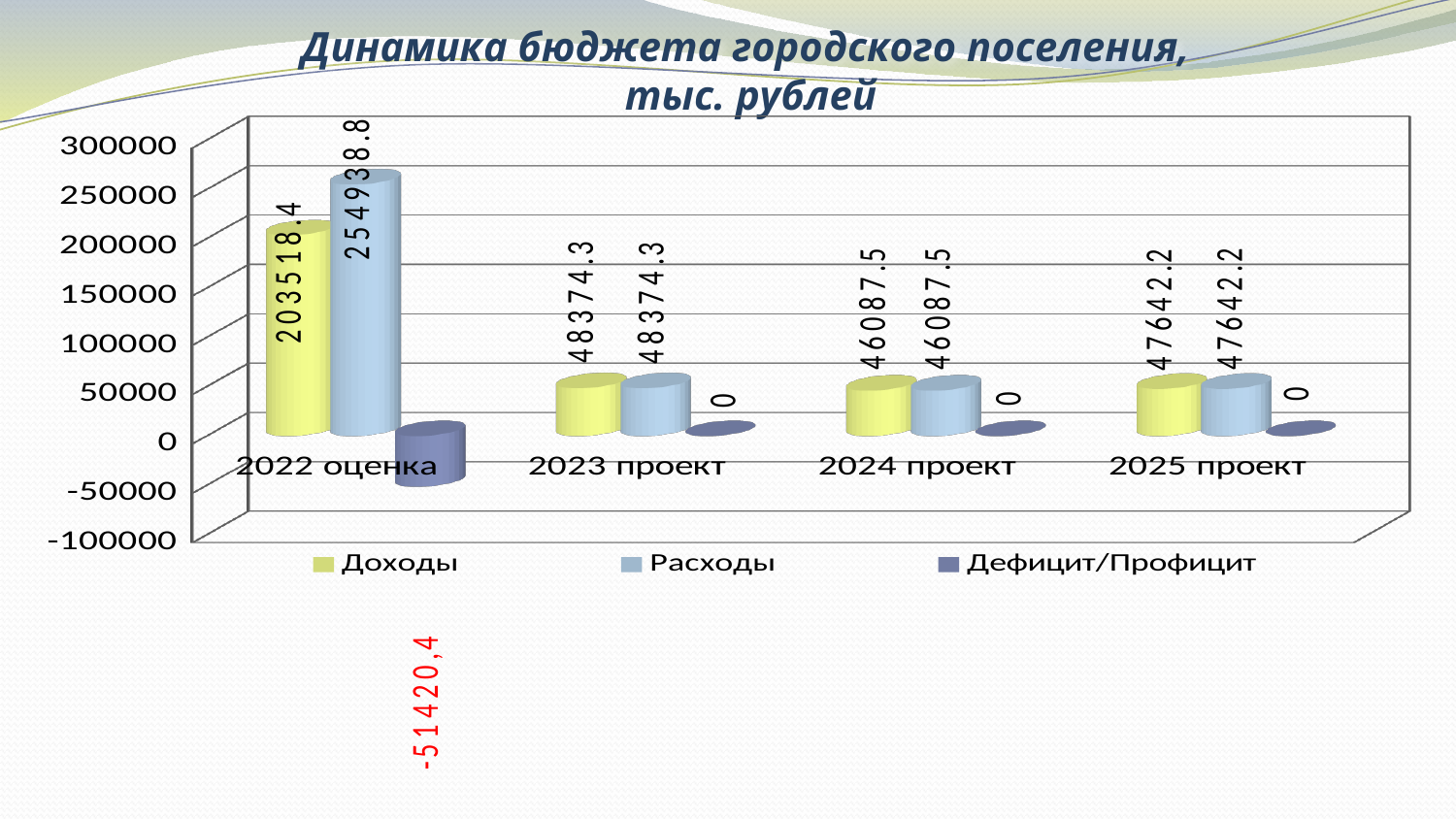
What is the value of Доходы for 2024 проект? 46087.5 What is the value of Расходы for 2022 оценка? 254938.8 How many categories are shown on the x axis? 4 How many series does the legend list? 3 What kind of chart is shown on the slide? bar chart What is the value of Расходы for 2025 проект? 47642.2 What is the value of Доходы for 2022 оценка? 203518.4 Which category has the highest value of Расходы? 2022 оценка What is the difference between Расходы and Доходы for 2022 оценка? 51420.4 What is the value of Дефицит/Профицит for 2023 проект? 0 Which category has the lowest value of Доходы? 2024 проект Which is larger for 2022 оценка: Доходы or Расходы? Расходы